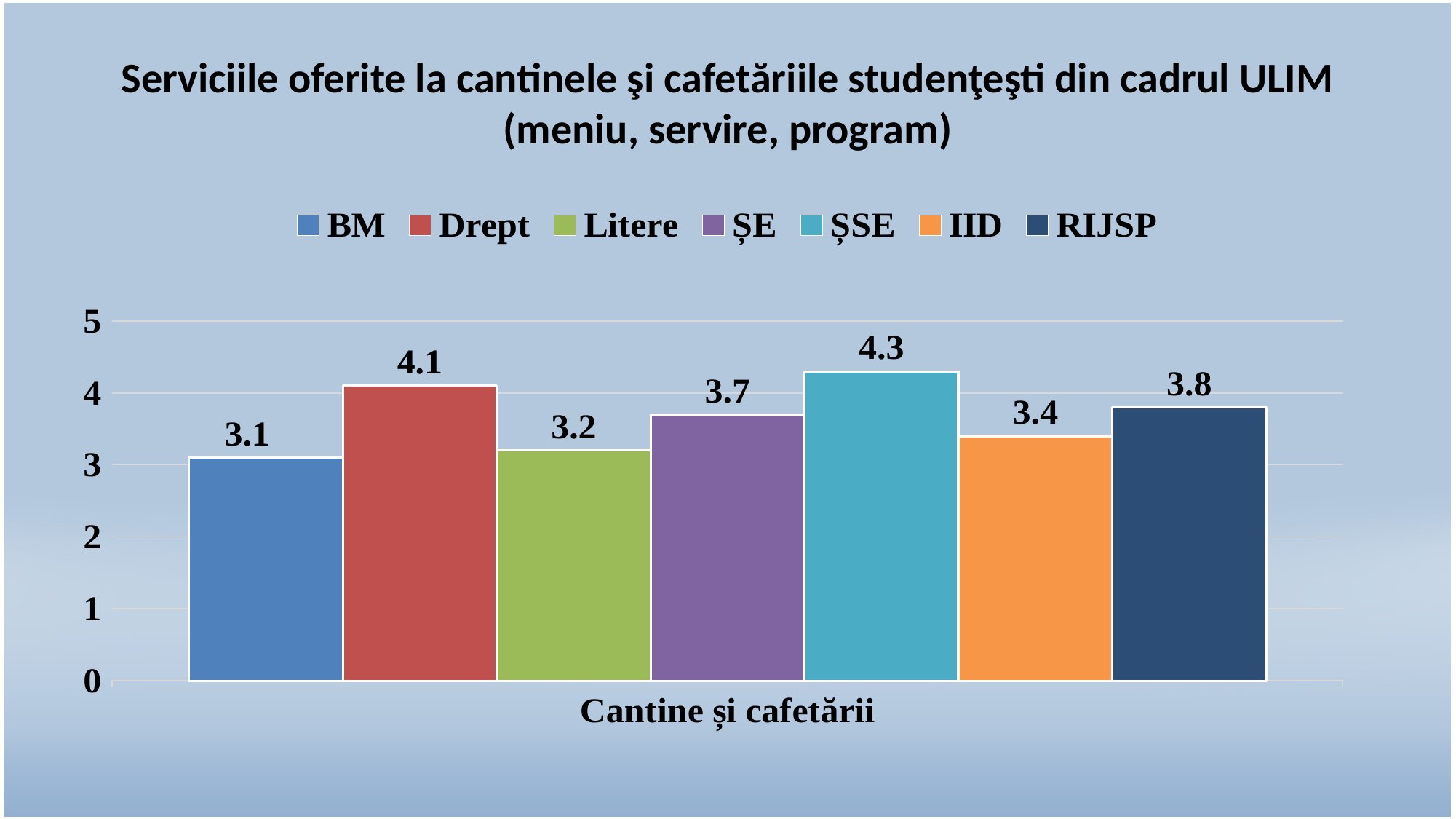
Which series has the lowest value? BM Which series has the highest value? ȘSE Is the value for Drept greater or less than 4? greater What is the value for Drept? 4.1 What is the difference between the values for ȘSE and BM? 1.2 How many bars are plotted in the chart? 7 What is the label on the horizontal axis of the chart? Cantine și cafetării Which is larger, the value for RIJSP or the value for Litere? RIJSP What is the value for ȘE? 3.7 What is the value for IID? 3.4 What kind of chart is shown on the slide? bar chart How many series does the legend list? 7